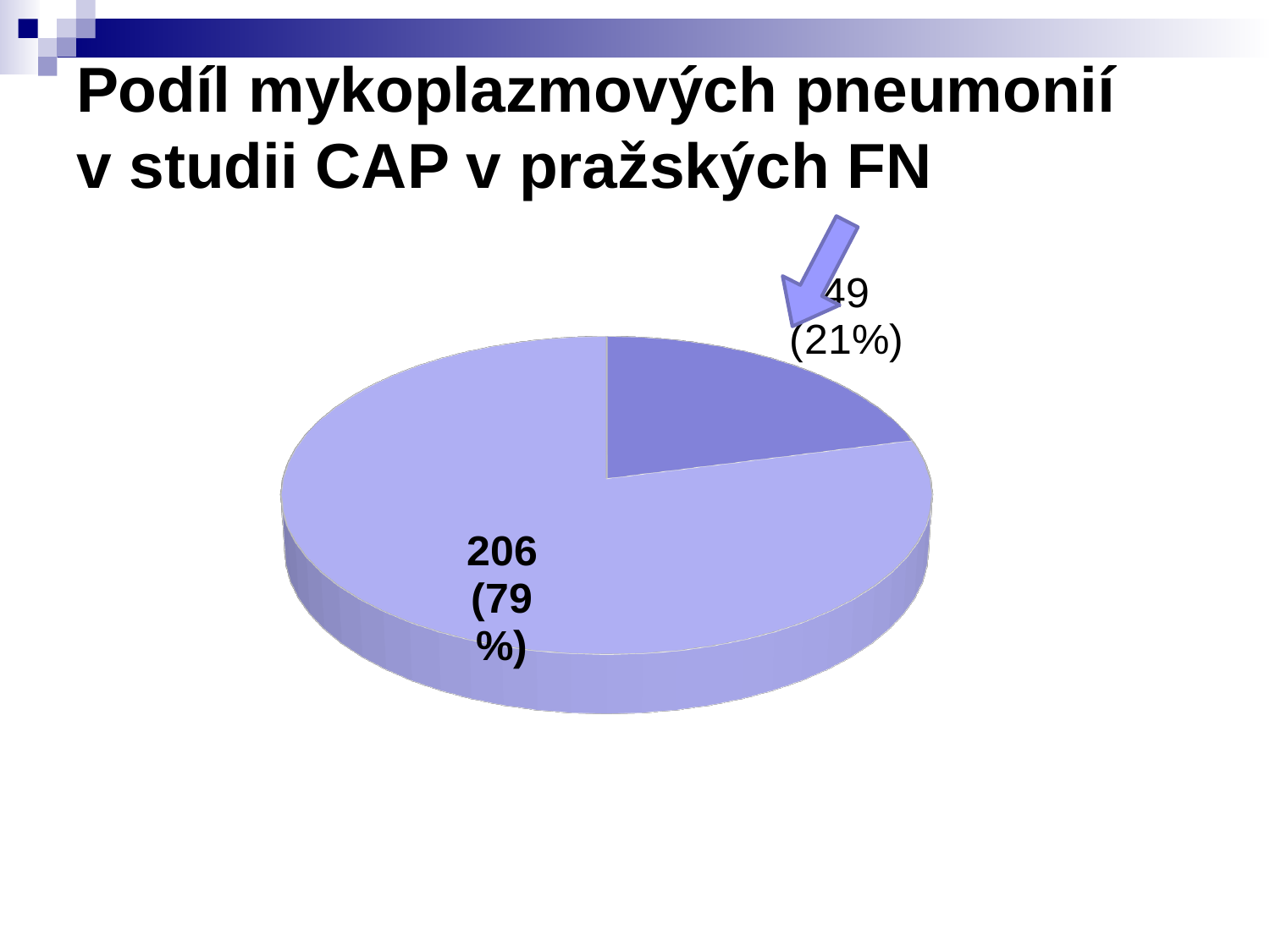
What is the title of the slide containing the pie chart? Podíl mykoplazmových pneumonií v studii CAP v pražských FN What percentage share is shown for the larger slice of the pie chart? 79 % How many slices does the pie chart have? 2 What is the total of the two values shown on the pie chart? 255 What value is printed on the larger slice of the pie chart? 206 What is the difference between the two values shown on the pie chart? 157 What percentage share is shown for the smaller slice of the pie chart? 21% Which slice is larger: the one labelled 206 or the one labelled 49? 206 What kind of chart is shown on the slide? pie chart What is the smallest value shown on the pie chart? 49 What value is printed on the smaller slice of the pie chart? 49 What is the largest value shown on the pie chart? 206